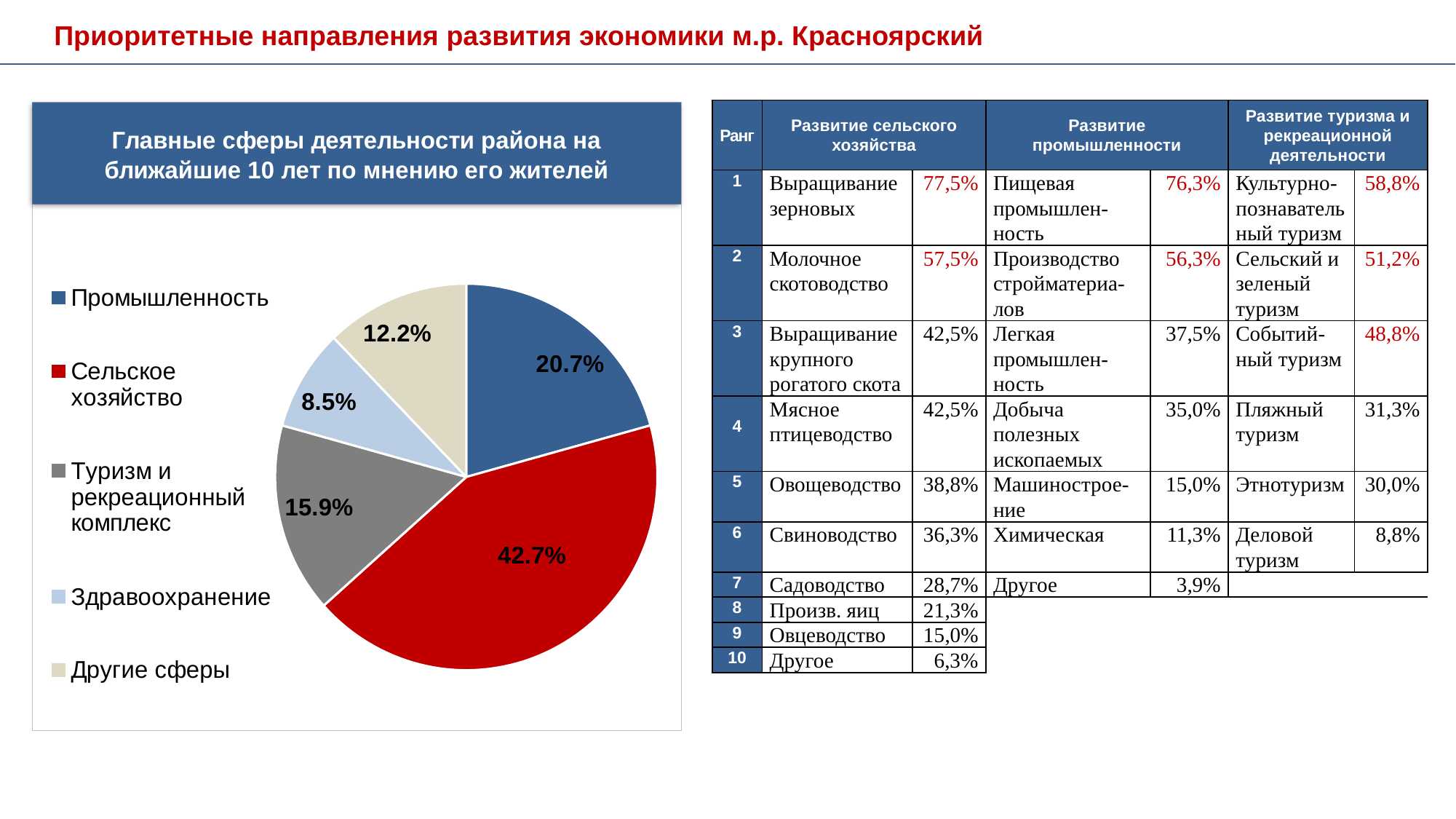
Which category has the smallest slice in the pie chart? Здравоохранение How many categories does the pie chart show? 5 What type of chart is shown on the slide? Pie chart Which is larger in the pie chart: "Другие сферы" or "Здравоохранение"? Другие сферы Which category has the largest slice in the pie chart? Сельское хозяйство What is the difference between the shares of "Сельское хозяйство" and "Промышленность"? 22.0% What is the title of the pie chart? Главные сферы деятельности района на ближайшие 10 лет по мнению его жителей What is the value shown for "Туризм и рекреационный комплекс" in the pie chart? 15.9% What is the value shown for "Промышленность" in the pie chart? 20.7% What is the value shown for "Другие сферы" in the pie chart? 12.2% What is the value shown for "Здравоохранение" in the pie chart? 8.5% What share of the pie does "Сельское хозяйство" have? 42.7%